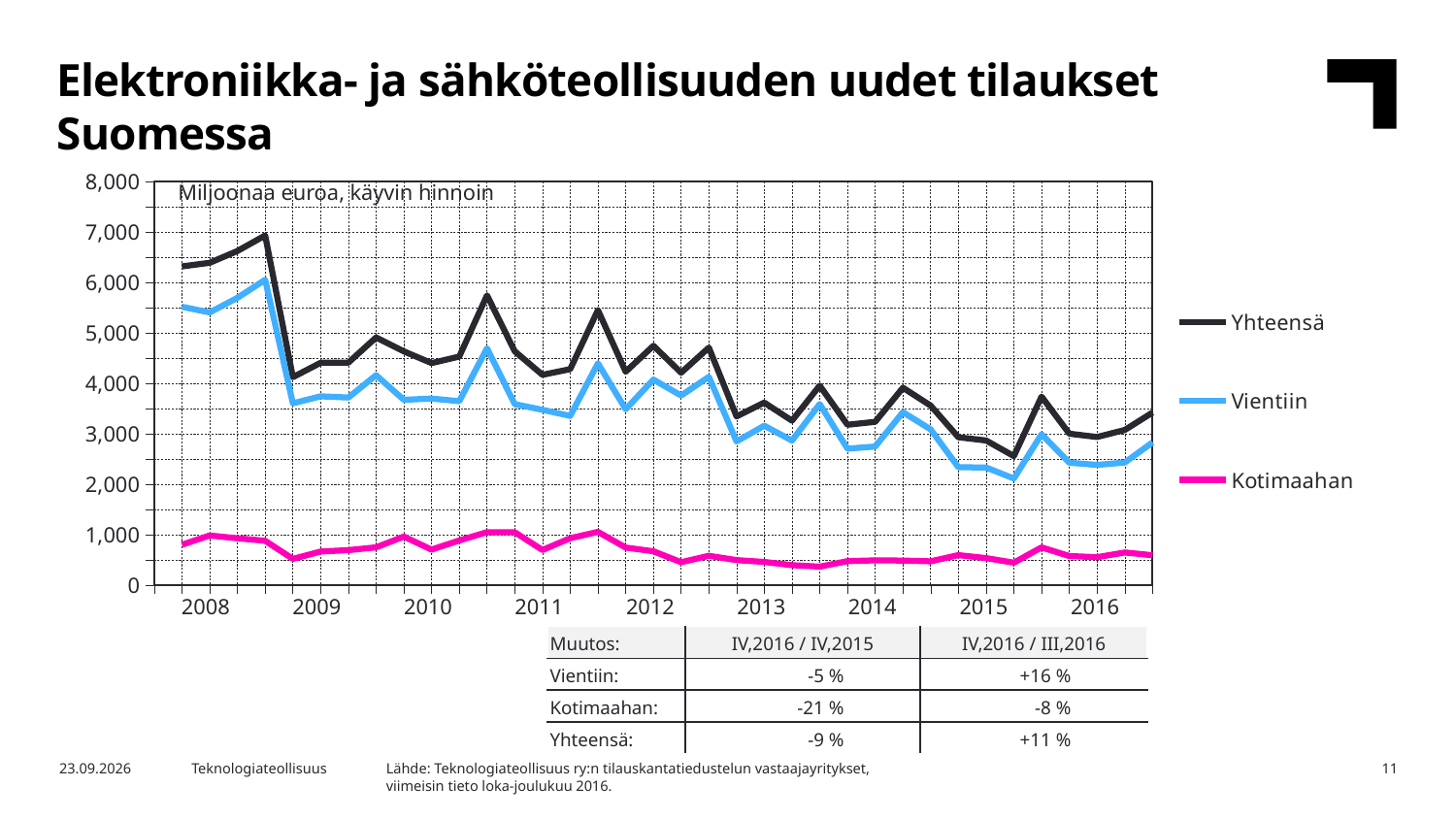
Is the value for Kotimaahan at any point greater or less than 2,000? less How many year labels are shown on the x axis? 9 Which series is larger in 2016, Vientiin or Kotimaahan? Vientiin Is the peak value of the Yhteensä series in 2008 greater or less than 6,000? greater Does the Yhteensä series generally rise or fall from 2008 to 2016? Fall Which series has the highest values throughout the chart? Yhteensä What kind of chart is shown on the slide? Line chart Which series has the lowest values throughout the chart? Kotimaahan How many series does the legend list? 3 What unit label is shown inside the chart area? Miljoonaa euroa, käyvin hinnoin What are the three series named in the legend? Yhteensä, Vientiin, Kotimaahan Is the value for Vientiin at the start of 2008 greater or less than 5,000? greater